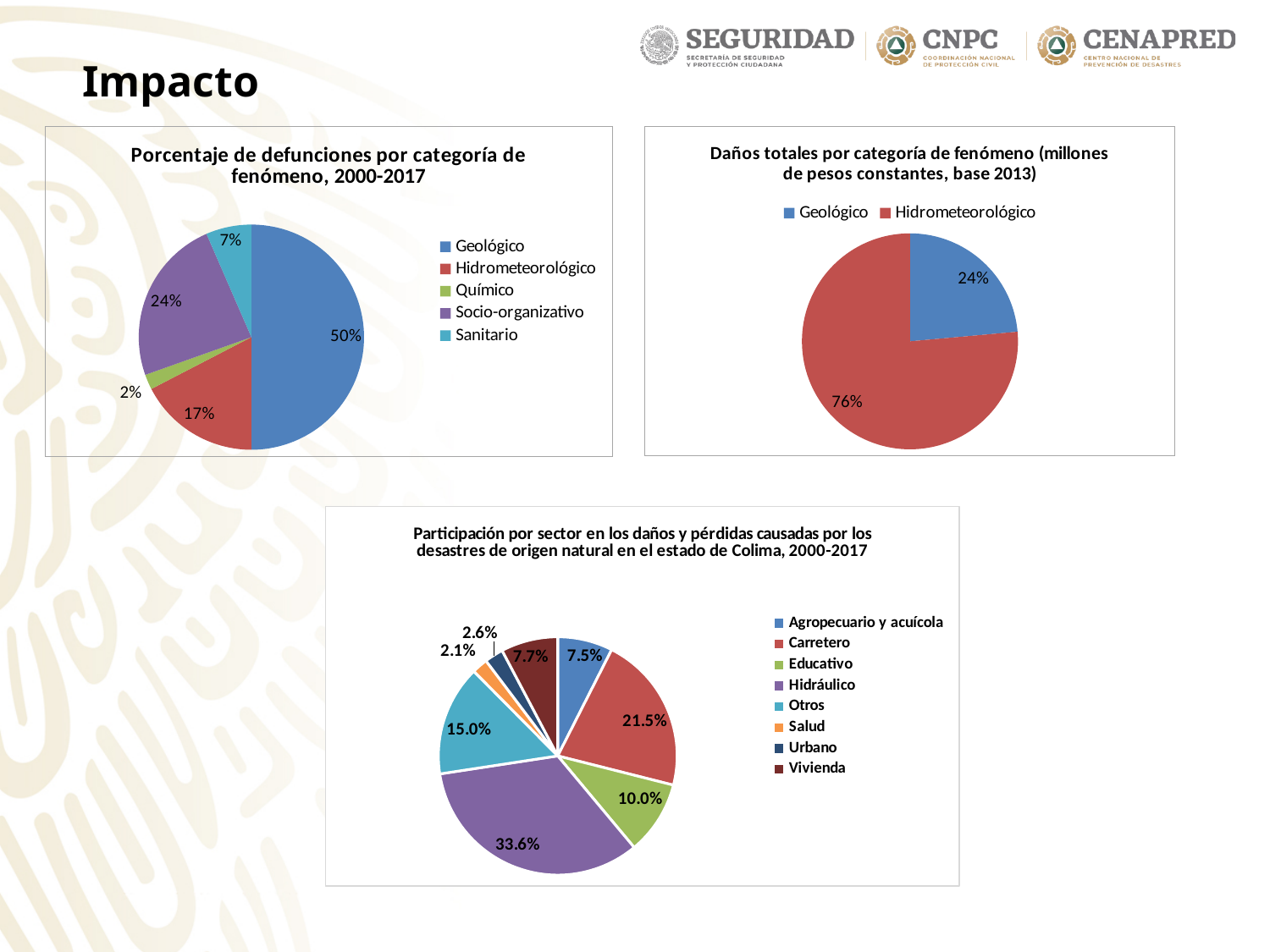
In the chart titled 'Participación por sector en los daños y pérdidas causadas por los desastres de origen natural en el estado de Colima, 2000-2017', how many sectors does the legend list? 8 In the chart titled 'Daños totales por categoría de fenómeno (millones de pesos constantes, base 2013)', what share corresponds to Hidrometeorológico? 76% What kind of chart is the one titled 'Daños totales por categoría de fenómeno (millones de pesos constantes, base 2013)'? Pie chart In the chart titled 'Participación por sector en los daños y pérdidas causadas por los desastres de origen natural en el estado de Colima, 2000-2017', what is the difference between the Carretero and Otros shares? 6.5% In the chart titled 'Participación por sector en los daños y pérdidas causadas por los desastres de origen natural en el estado de Colima, 2000-2017', what is the share for Salud? 2.1% In the chart titled 'Porcentaje de defunciones por categoría de fenómeno, 2000-2017', what share of deaths is attributed to Geológico? 50% In the chart titled 'Porcentaje de defunciones por categoría de fenómeno, 2000-2017', what is the difference between the Socio-organizativo and Hidrometeorológico shares? 7% In the chart titled 'Daños totales por categoría de fenómeno (millones de pesos constantes, base 2013)', which category has the larger share, Geológico or Hidrometeorológico? Hidrometeorológico In the chart titled 'Porcentaje de defunciones por categoría de fenómeno, 2000-2017', which category has the smallest share? Químico In the chart titled 'Participación por sector en los daños y pérdidas causadas por los desastres de origen natural en el estado de Colima, 2000-2017', what is the share for Hidráulico? 33.6% In the chart titled 'Participación por sector en los daños y pérdidas causadas por los desastres de origen natural en el estado de Colima, 2000-2017', which sector has the largest share? Hidráulico In the chart titled 'Porcentaje de defunciones por categoría de fenómeno, 2000-2017', how many categories does the legend list? 5